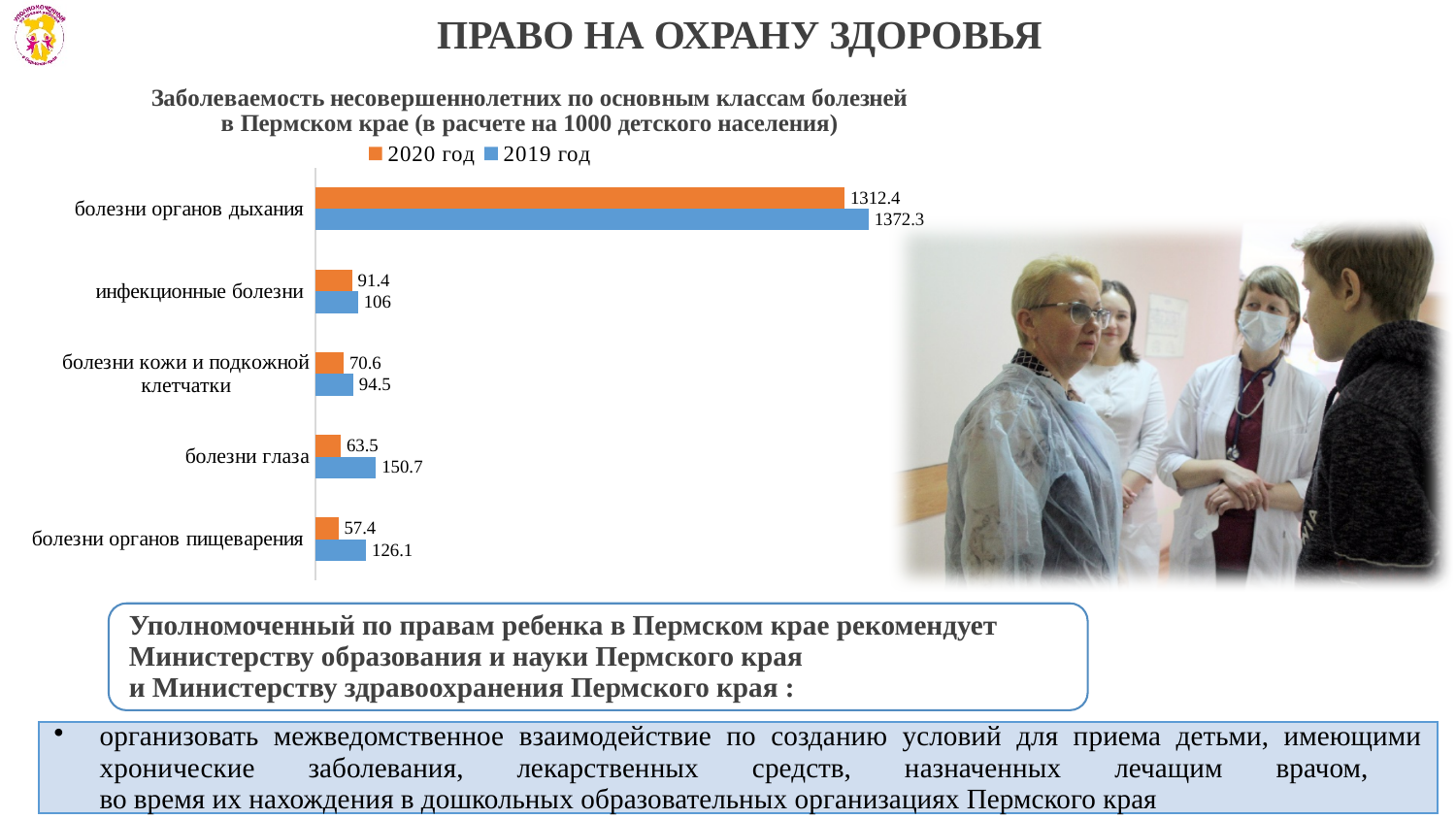
Which category has the highest value in 2019 год? болезни органов дыхания What is the value for инфекционные болезни in 2019 год? 106 Which category has the lowest value in 2020 год? болезни органов пищеварения Which colour represents 2020 год in the chart? orange What is the value for болезни глаза in 2019 год? 150.7 What is the value for болезни органов дыхания in 2020 год? 1312.4 What is the difference between the 2019 год and 2020 год values for болезни органов дыхания? 59.9 Which is larger for болезни кожи и подкожной клетчатки: the 2020 год value or the 2019 год value? 2019 год How many series does the legend list? 2 What kind of chart is shown on the slide? bar chart How many disease categories are shown on the chart? 5 What is the value for болезни органов пищеварения in 2020 год? 57.4